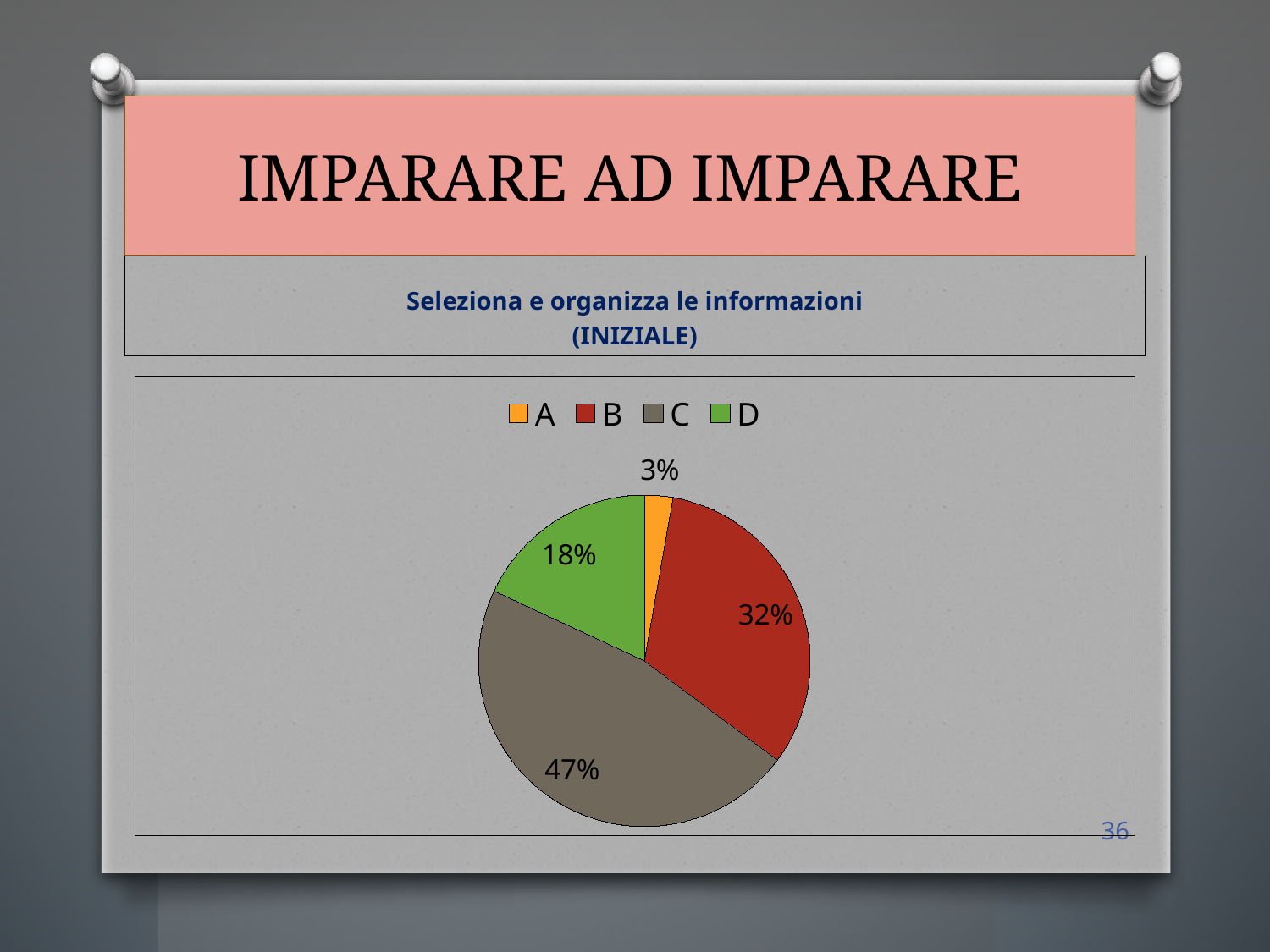
What colour is the slice for category D? green What percentage does slice B represent? 32% What percentage does slice D represent? 18% How many slices does the pie chart have? 4 What kind of chart is shown on the slide? pie chart How many entries does the legend list? 4 Which category has the smallest share of the pie? A What percentage does slice A represent? 3% What is the difference in percentage points between C and B? 15 Which category has the largest share of the pie? C What percentage does slice C represent? 47% Which is larger, the share for B or the share for D? B